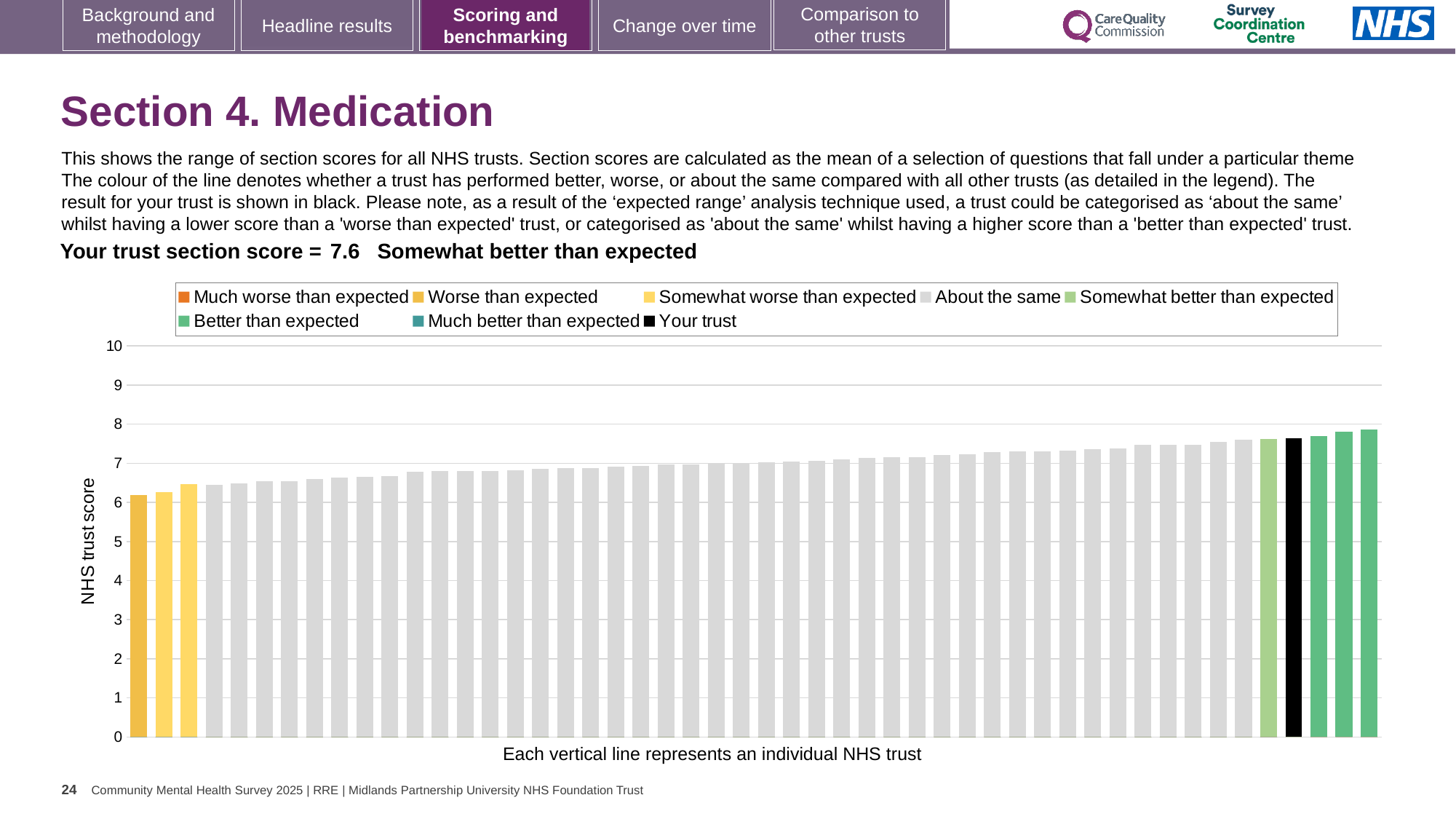
Is the value of the black bar (your trust) greater or less than 7? greater Is the value of the lowest bar greater or less than 6? greater How many bars are coloured as 'Better than expected' (green) to the right of the black bar? 3 What is the label on the vertical axis of the chart? NHS trust score How many entries does the chart legend list? 8 Which category is your trust's section score placed in? Somewhat better than expected Is the value of the leftmost bar greater or less than 7? less What is the section score for your trust shown on the slide? 7.6 How many bars are coloured as 'Worse than expected' (yellow)? 1 Do the bar values rise or fall from left to right along the x axis? rise What type of chart is shown on the slide? bar chart